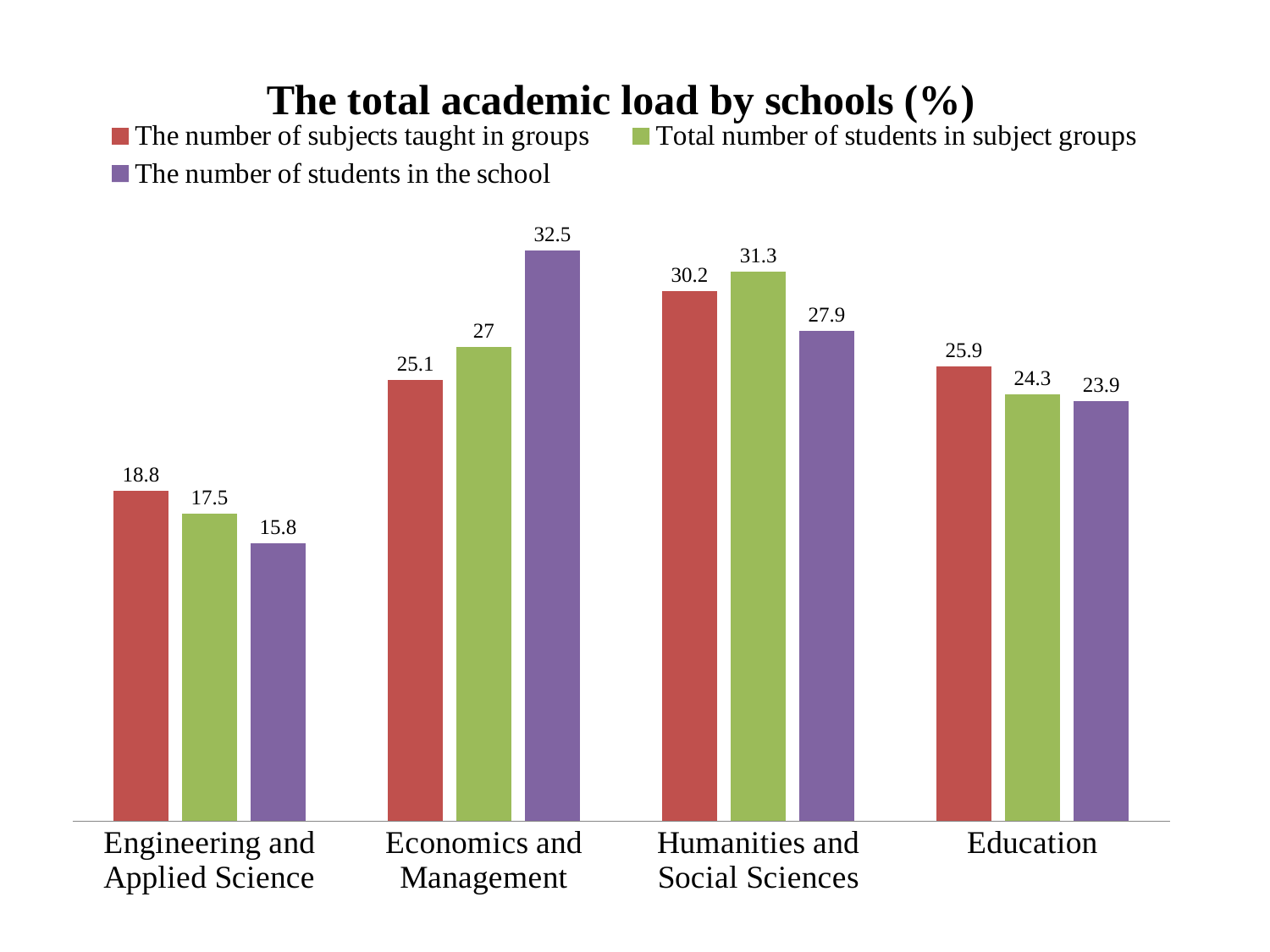
Which is larger for Education: 'The number of subjects taught in groups' or 'Total number of students in subject groups'? The number of subjects taught in groups What is the value for 'The number of subjects taught in groups' for Engineering and Applied Science? 18.8 How many series does the legend list? 3 What kind of chart is shown on the slide? Bar chart Which school has the highest value for 'The number of students in the school'? Economics and Management What is the title of the chart? The total academic load by schools (%) How many schools are shown on the x axis? 4 What is the value for 'The number of students in the school' for Education? 23.9 What is the difference between 'The number of students in the school' and 'The number of subjects taught in groups' for Economics and Management? 7.4 What is the value for 'Total number of students in subject groups' for Humanities and Social Sciences? 31.3 Which school has the lowest value for 'The number of subjects taught in groups'? Engineering and Applied Science What is the value for 'The number of students in the school' for Economics and Management? 32.5